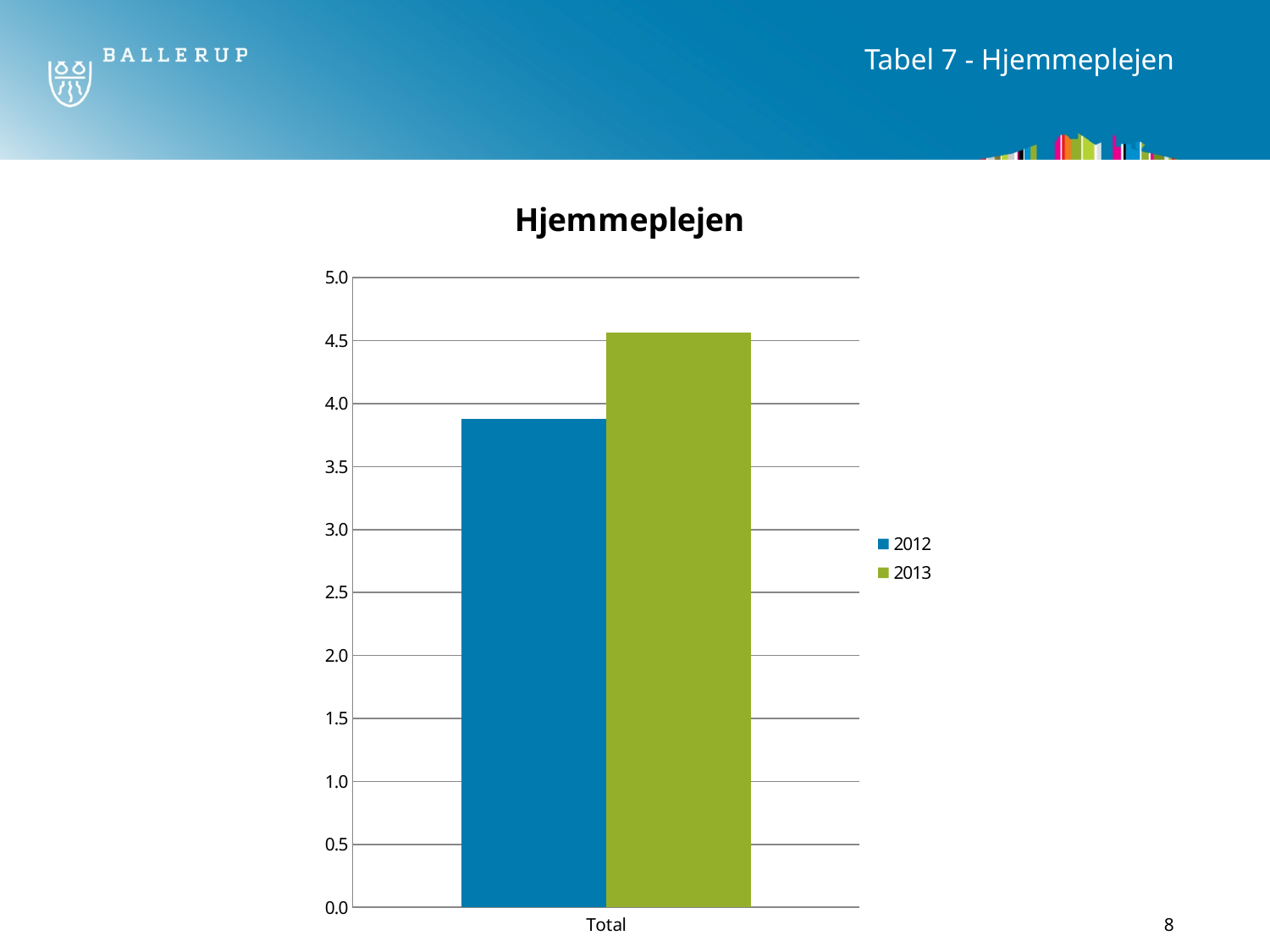
How many series does the legend list? 2 Is the value for 2012 greater or less than 4.0? less Is the value for 2012 greater or less than 3.5? greater How many categories are shown on the x axis? 1 Is the value for 2013 greater or less than 5.0? less What is the title of the chart? Hjemmeplejen What is the label of the category on the x axis? Total Which series has the higher value for Total, 2012 or 2013? 2013 Which series has the lowest bar in the chart? 2012 What kind of chart is shown on the slide? bar chart Which series has the highest bar in the chart? 2013